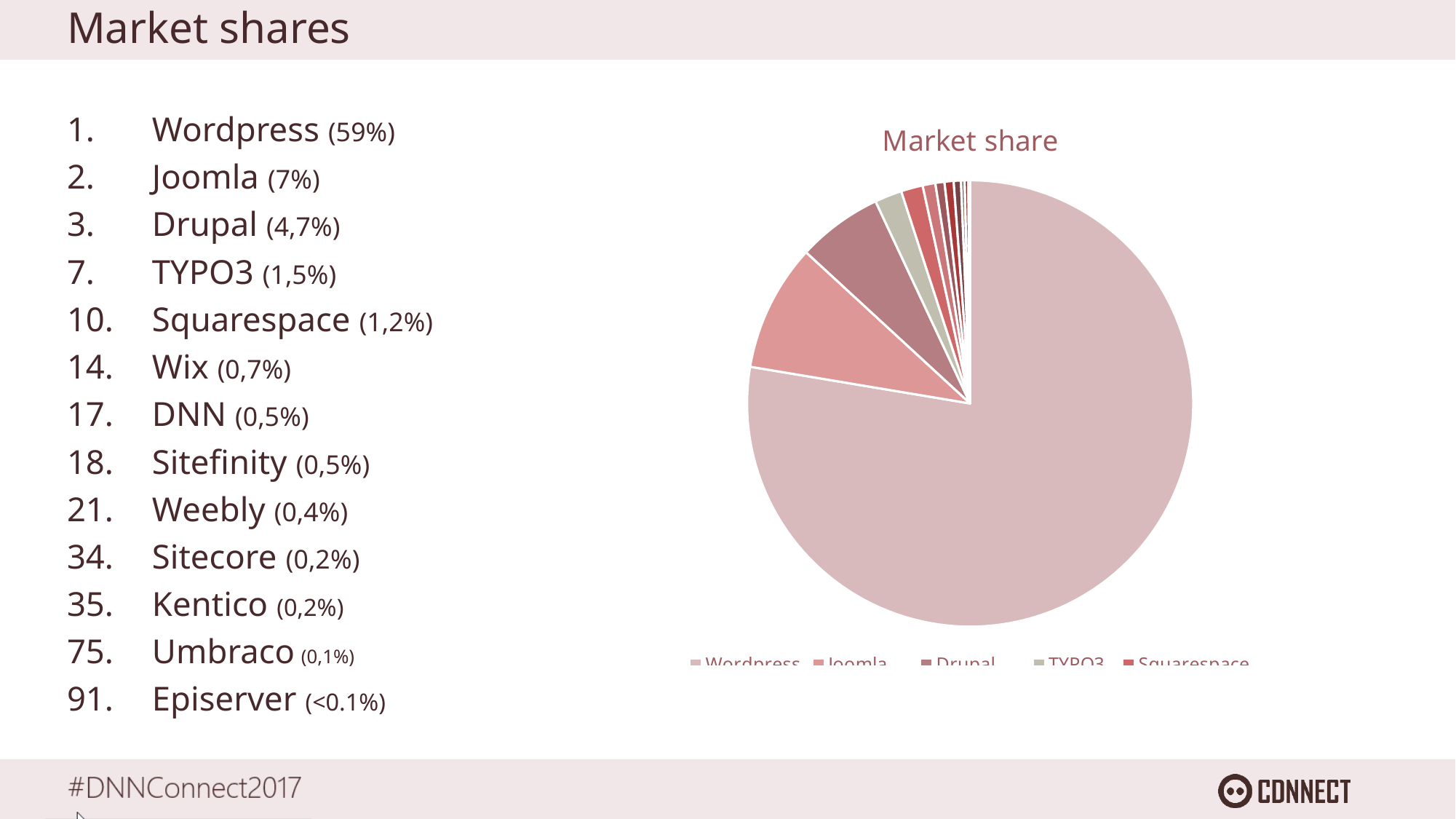
What is the title of the chart? Market share What market share is shown for Wordpress? 59% What is the difference between the market shares of Wordpress and Joomla? 52% What market share is shown for Squarespace? 1,2% What kind of chart is shown on the slide? pie chart What market share is shown for Drupal? 4,7% Which has the larger slice, Wordpress or Joomla? Wordpress Which category has the largest slice of the pie? Wordpress Which has the larger slice, Joomla or Drupal? Joomla What market share is shown for Joomla? 7% What market share is shown for TYPO3? 1,5% Which category is listed first in the chart legend? Wordpress